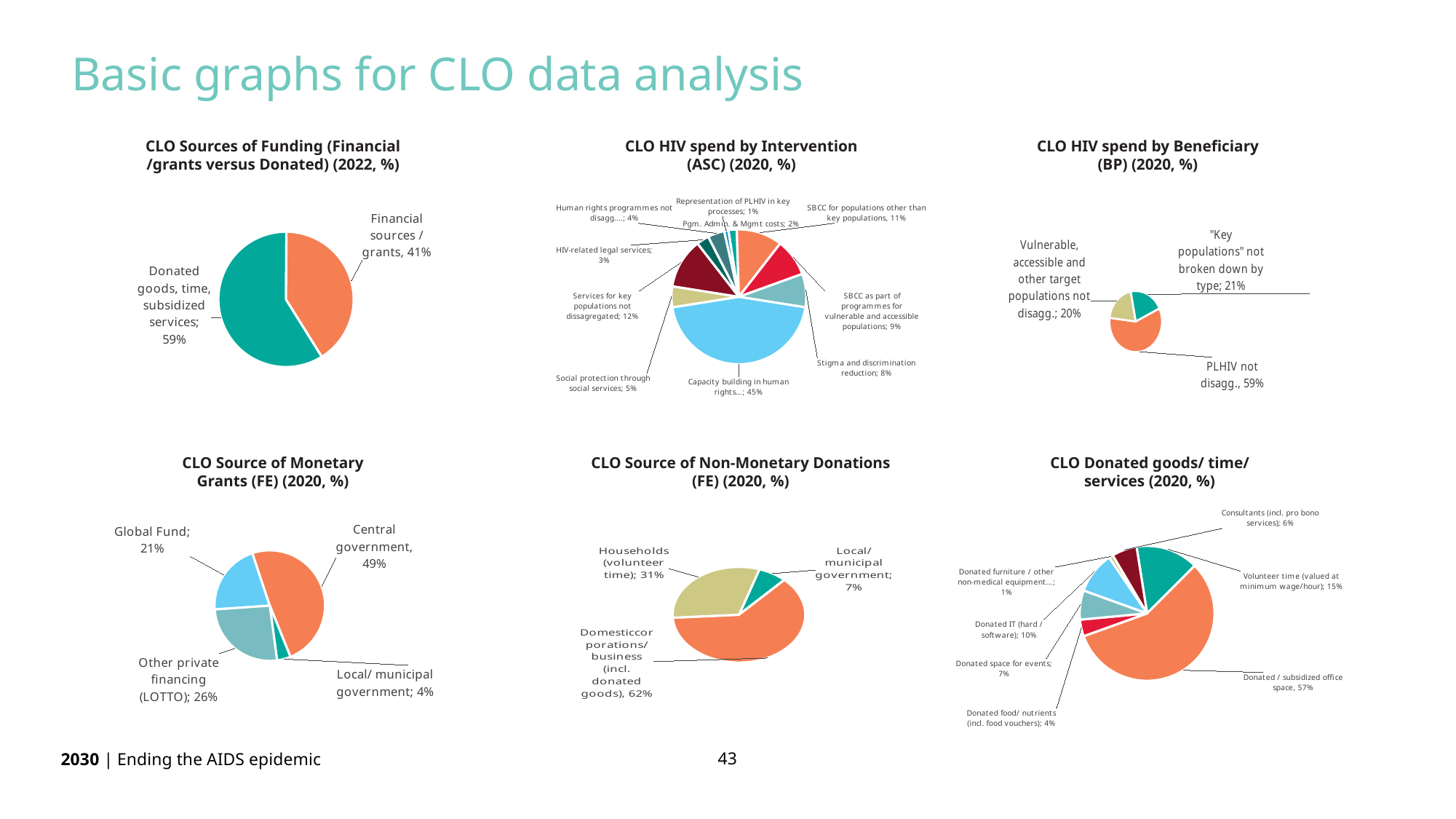
In the 'CLO Source of Monetary Grants (FE)' chart, which is larger: Global Fund or Other private financing (LOTTO)? Other private financing (LOTTO) In the 'CLO HIV spend by Beneficiary (BP)' chart, what is the share for PLHIV not disagg.? 59% In the 'CLO HIV spend by Intervention (ASC)' chart, which intervention has the largest share? Capacity building in human rights... How many slices does the 'CLO HIV spend by Intervention (ASC)' chart have? 10 In the 'CLO Sources of Funding' chart, what share comes from donated goods, time, subsidized services? 59% In the 'CLO HIV spend by Intervention (ASC)' chart, which intervention has the smallest share? Representation of PLHIV in key processes In the 'CLO Donated goods/ time/ services' chart, what is the difference between Donated / subsidized office space and Volunteer time? 42% In the 'CLO HIV spend by Beneficiary (BP)' chart, what is the difference between the 'Key populations' not broken down by type share and the Vulnerable, accessible and other target populations share? 1% In the 'CLO Source of Non-Monetary Donations (FE)' chart, what is the share for Households (volunteer time)? 31% In the 'CLO HIV spend by Intervention (ASC)' chart, what is the share for Services for key populations not dissagregated? 12% What type of chart is used for 'CLO Donated goods/ time/ services (2020, %)'? Pie chart In the 'CLO Source of Monetary Grants (FE)' chart, what share comes from Central government? 49%